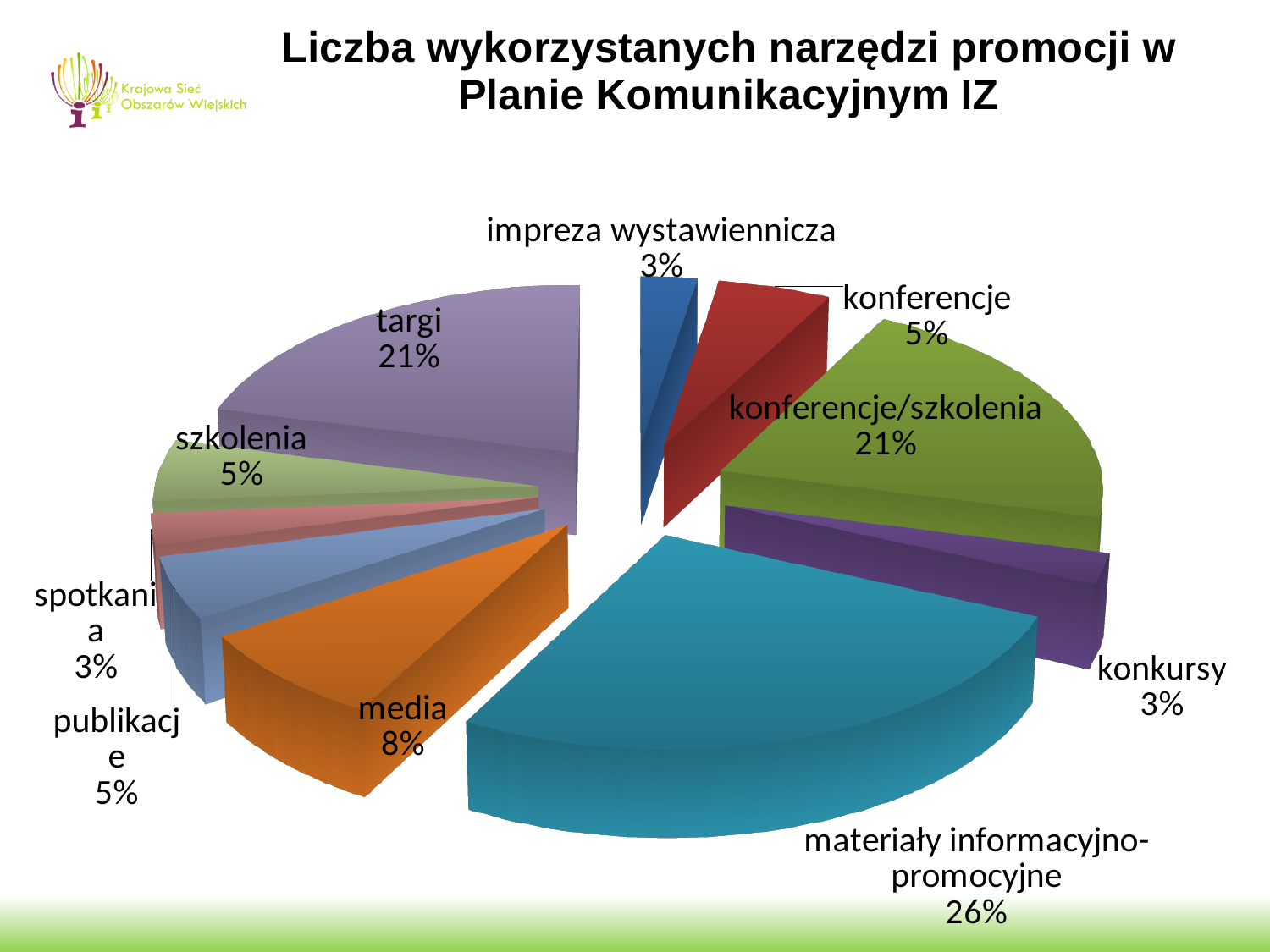
What is the difference in percentage points between 'materiały informacyjno-promocyjne' and 'media'? 18 What share of the pie does 'materiały informacyjno-promocyjne' have? 26% What percentage is shown for 'targi'? 21% How many categories (slices) does the pie chart have? 10 What is the title of the chart? Liczba wykorzystanych narzędzi promocji w Planie Komunikacyjnym IZ What is the difference in percentage points between 'targi' and 'konkursy'? 18 What percentage is shown for 'konferencje'? 5% What kind of chart is shown on the slide? pie chart What percentage is shown for 'spotkania'? 3% What percentage is shown for 'media'? 8% Which is larger, the share for 'media' or the share for 'szkolenia'? media Which category has the largest slice of the pie? materiały informacyjno-promocyjne